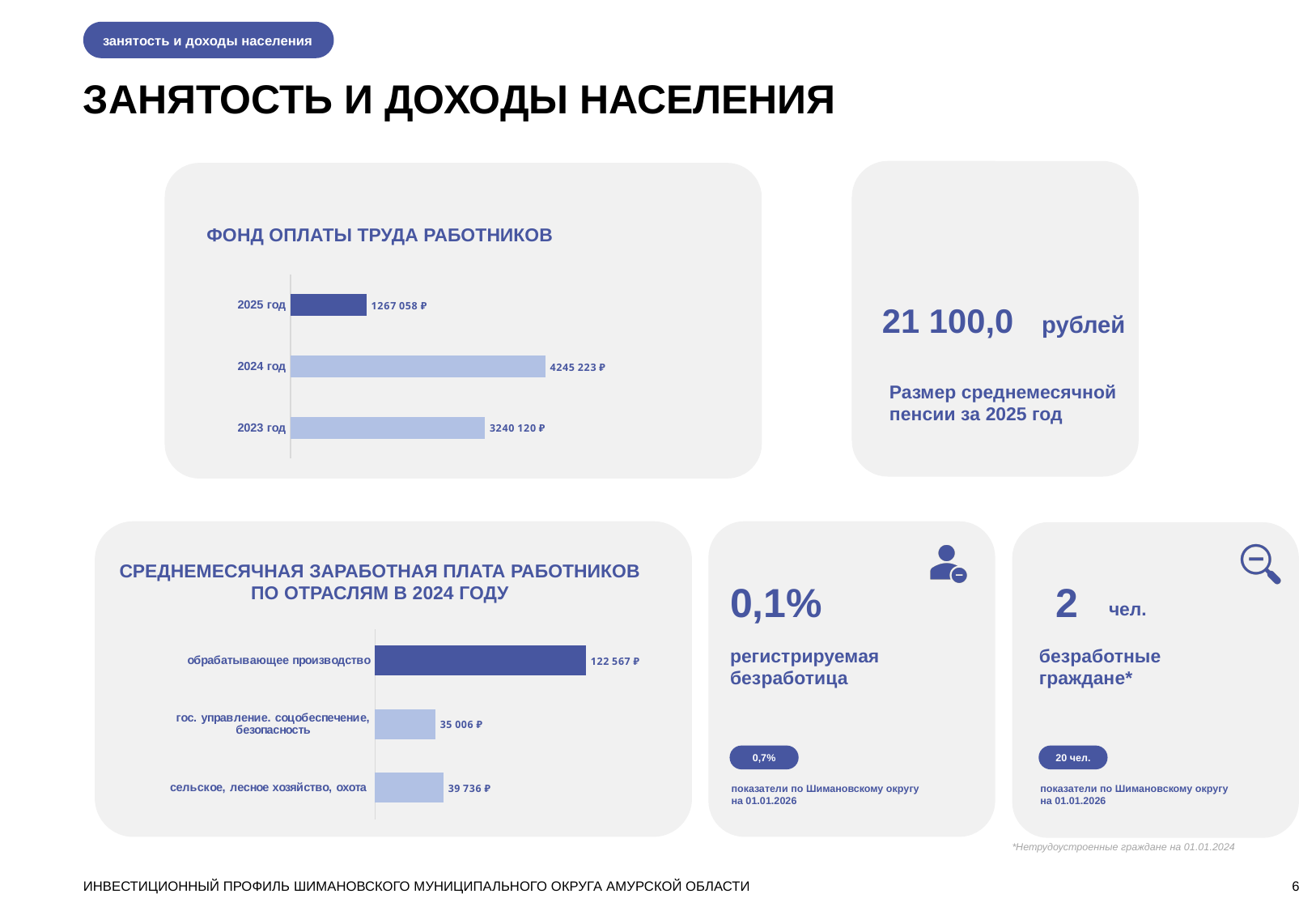
In the chart 'СРЕДНЕМЕСЯЧНАЯ ЗАРАБОТНАЯ ПЛАТА РАБОТНИКОВ ПО ОТРАСЛЯМ В 2024 ГОДУ', what is the value for сельское, лесное хозяйство, охота? 39 736 ₽ In the chart 'СРЕДНЕМЕСЯЧНАЯ ЗАРАБОТНАЯ ПЛАТА РАБОТНИКОВ ПО ОТРАСЛЯМ В 2024 ГОДУ', what is the difference between обрабатывающее производство and сельское, лесное хозяйство, охота? 82 831 ₽ In the chart 'СРЕДНЕМЕСЯЧНАЯ ЗАРАБОТНАЯ ПЛАТА РАБОТНИКОВ ПО ОТРАСЛЯМ В 2024 ГОДУ', which industry has the lowest value? гос. управление. соцобеспечение, безопасность In the chart 'ФОНД ОПЛАТЫ ТРУДА РАБОТНИКОВ', how many years are shown? 3 In the chart 'ФОНД ОПЛАТЫ ТРУДА РАБОТНИКОВ', what is the value for 2025 год? 1267 058 ₽ In the chart 'ФОНД ОПЛАТЫ ТРУДА РАБОТНИКОВ', which year has the lowest value? 2025 год In the chart 'СРЕДНЕМЕСЯЧНАЯ ЗАРАБОТНАЯ ПЛАТА РАБОТНИКОВ ПО ОТРАСЛЯМ В 2024 ГОДУ', which is larger: сельское, лесное хозяйство, охота or гос. управление. соцобеспечение, безопасность? сельское, лесное хозяйство, охота In the chart 'ФОНД ОПЛАТЫ ТРУДА РАБОТНИКОВ', what is the value for 2024 год? 4245 223 ₽ What type of chart is 'ФОНД ОПЛАТЫ ТРУДА РАБОТНИКОВ'? Bar chart In the chart 'ФОНД ОПЛАТЫ ТРУДА РАБОТНИКОВ', what is the difference between the values for 2024 год and 2023 год? 1 005 103 ₽ In the chart 'ФОНД ОПЛАТЫ ТРУДА РАБОТНИКОВ', which year has the highest value? 2024 год In the chart 'СРЕДНЕМЕСЯЧНАЯ ЗАРАБОТНАЯ ПЛАТА РАБОТНИКОВ ПО ОТРАСЛЯМ В 2024 ГОДУ', what is the value for обрабатывающее производство? 122 567 ₽